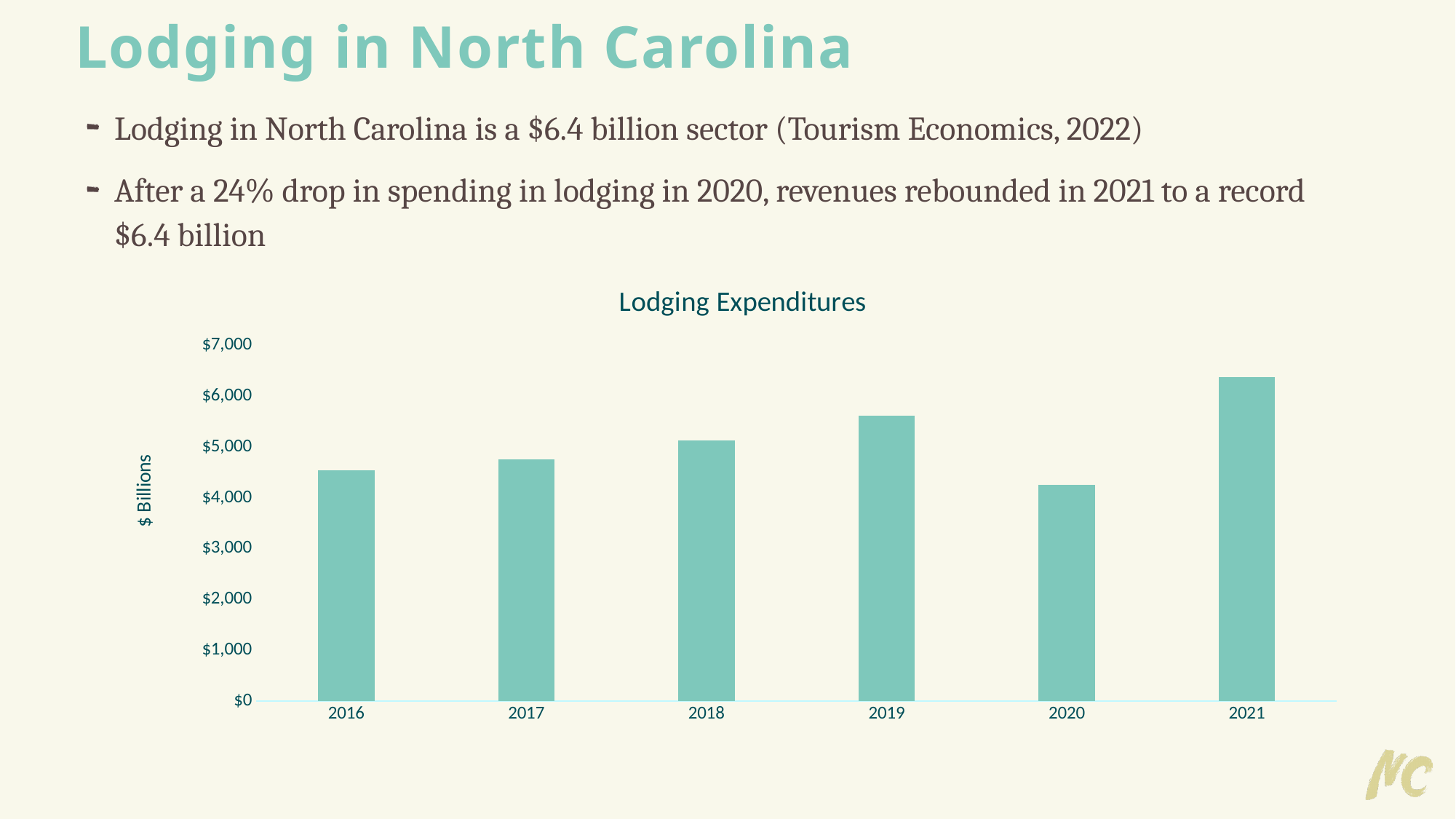
Is the value for 2021 greater or less than $6,000? greater Which year has the highest lodging expenditures? 2021 Is the value for 2019 greater or less than $5,000? greater Do lodging expenditures rise or fall from 2016 to 2019? rise Which year has the lowest lodging expenditures? 2020 Is the value for 2016 greater or less than $4,000? greater Which year has higher lodging expenditures, 2017 or 2018? 2018 What is the label on the vertical axis of the chart? $ Billions How many years are plotted in the Lodging Expenditures chart? 6 What kind of chart is shown on the slide? bar chart Which year has higher lodging expenditures, 2019 or 2020? 2019